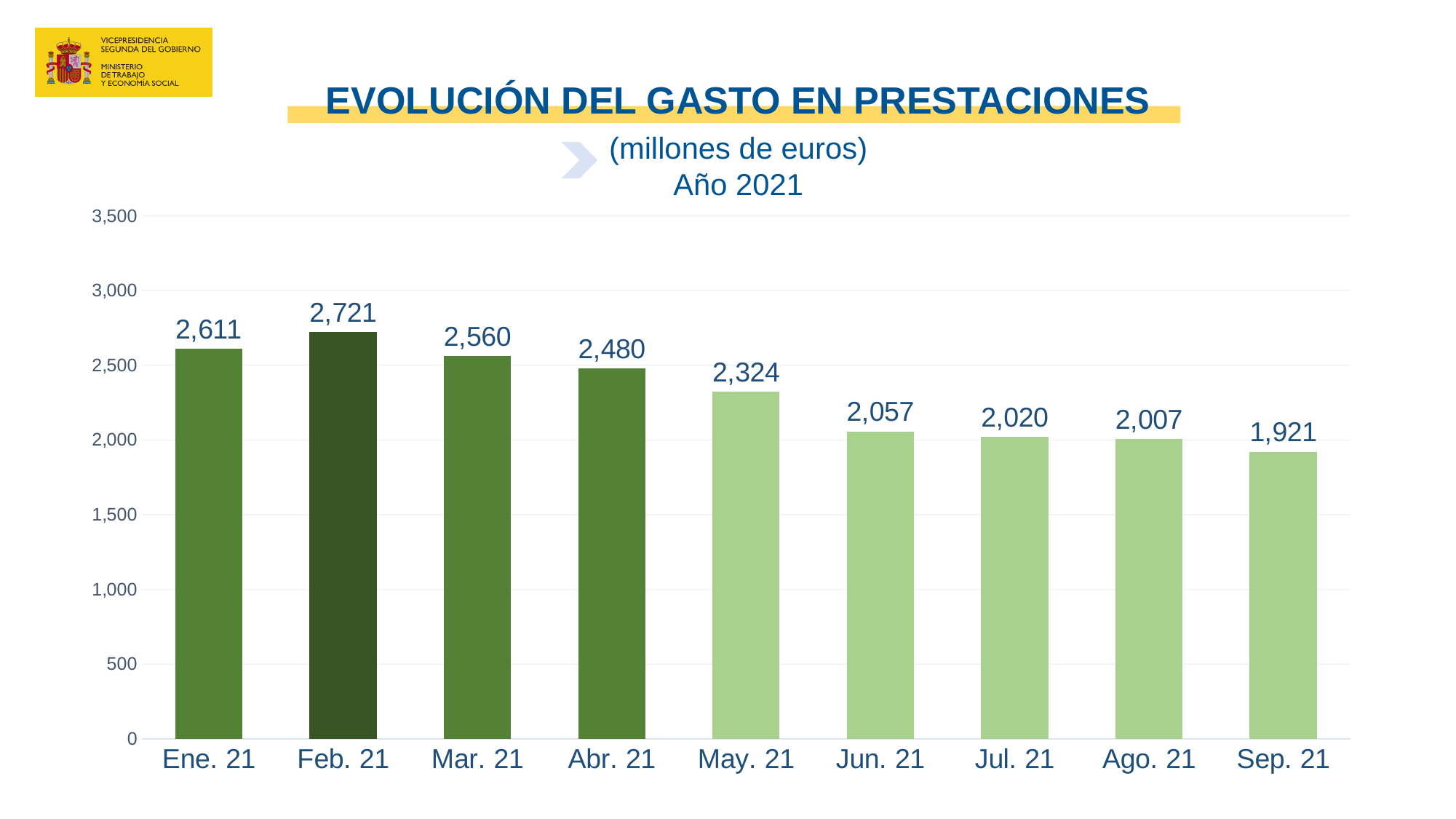
Which month has the highest value? Feb. 21 Do the values generally rise or fall from Feb. 21 to Sep. 21? fall Which is larger, the value for Abr. 21 or the value for Jun. 21? Abr. 21 Which month has the lowest value? Sep. 21 Is the value for Jul. 21 greater or less than 2,500? less What is the value for Feb. 21? 2,721 What is the difference between the values for Feb. 21 and Sep. 21? 800 What is the difference between the values for Ene. 21 and Mar. 21? 51 What is the value for Sep. 21? 1,921 What kind of chart is shown on the slide? bar chart How many months are shown on the x axis? 9 What is the value for May. 21? 2,324